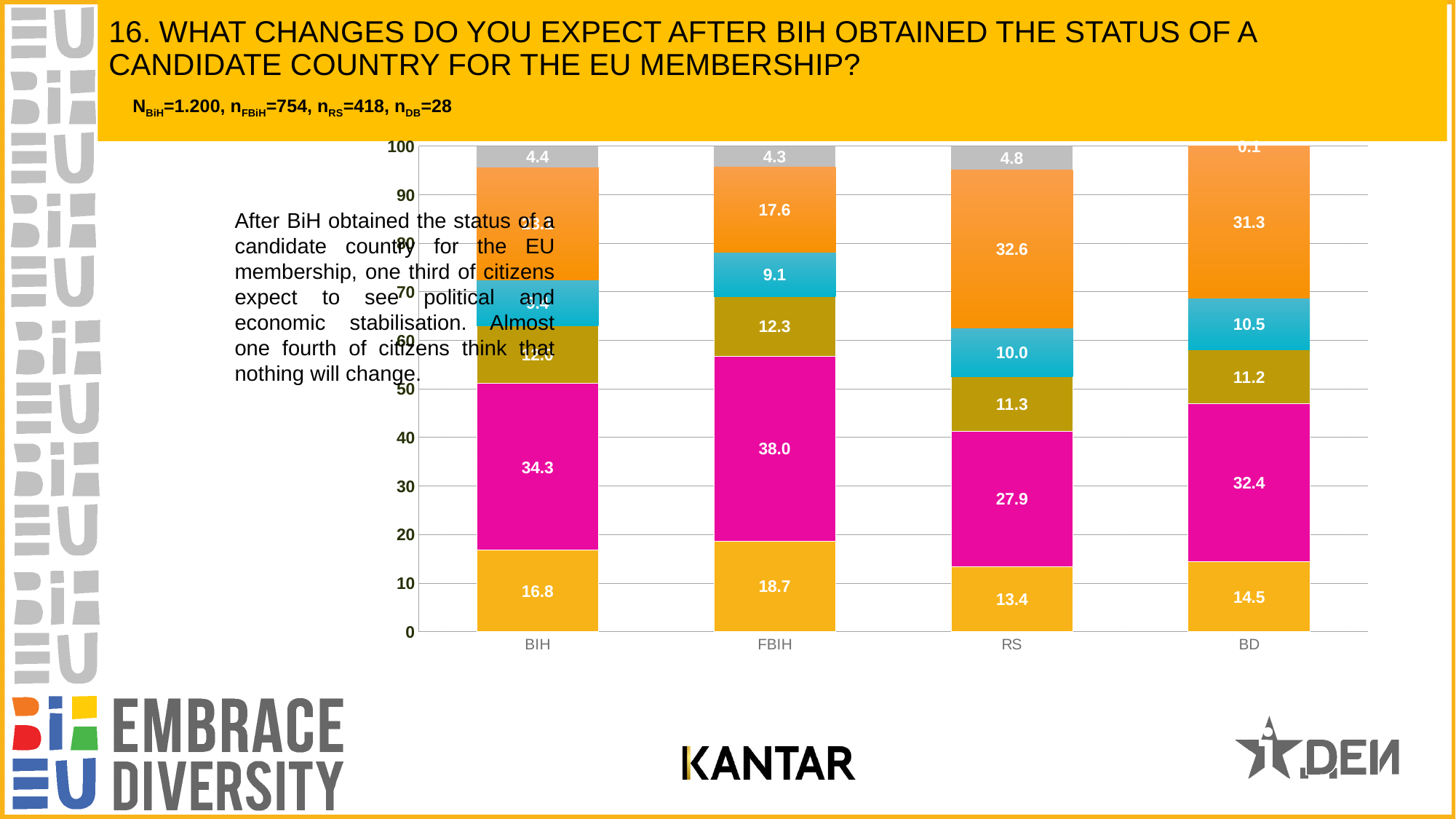
What is the value of the cyan segment for BD? 10.5 What is the value of the bottom (yellow) segment for FBIH? 18.7 What is the difference between the magenta segment values for FBIH and RS? 10.1 What type of chart is shown on the slide? stacked bar chart Which is larger, the orange segment for RS or the orange segment for FBIH? RS What is the value of the magenta segment for RS? 27.9 What is the value of the grey top segment for BIH? 4.4 Which category has the highest value in the magenta segment? FBIH Which category has the lowest value in the bottom (yellow) segment? RS What are the category labels on the x axis of the chart? BIH, FBIH, RS, BD What is the value of the orange segment for BD? 31.3 How many categories are shown on the x axis of the chart? 4